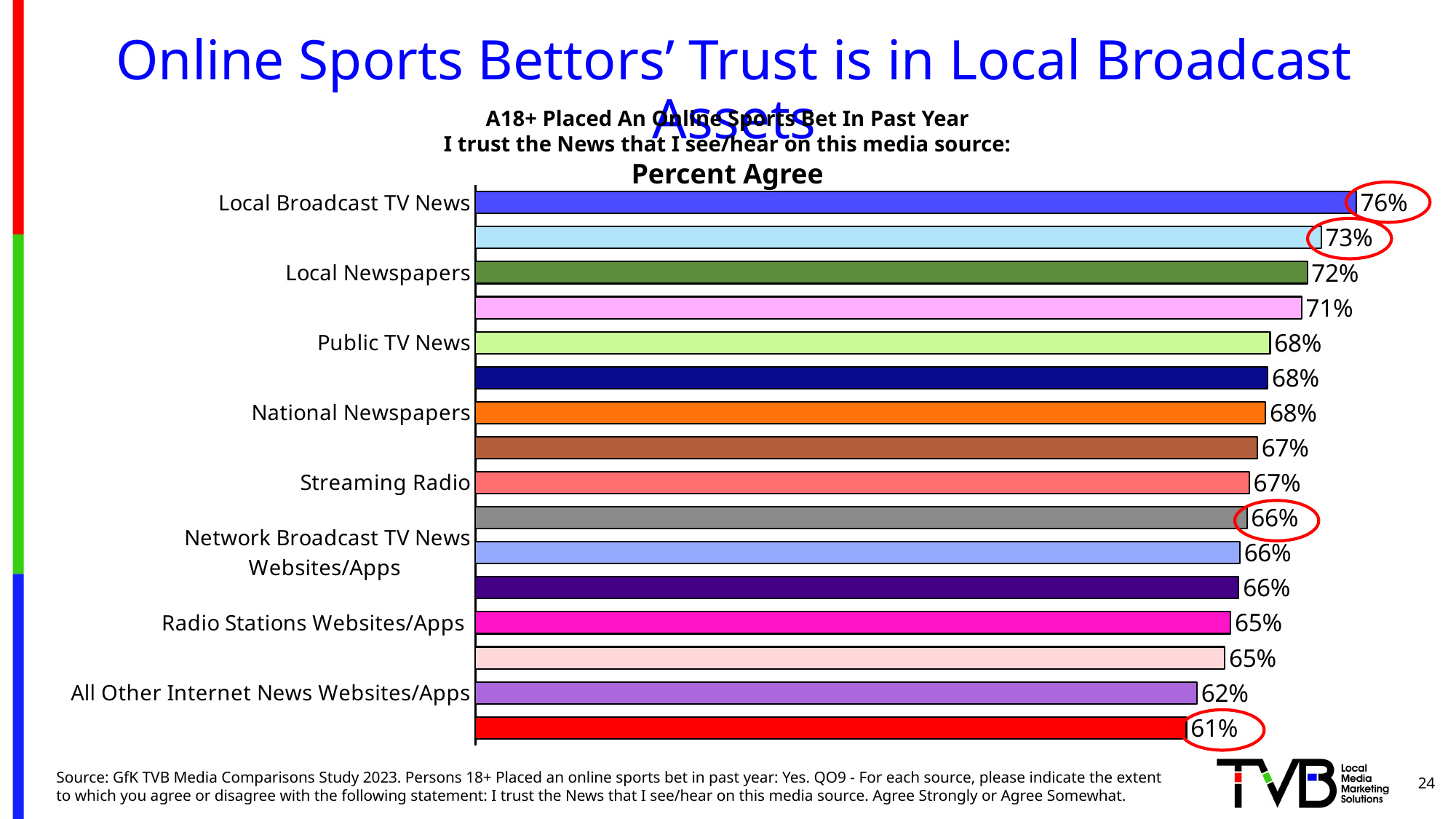
Which has a higher Percent Agree value, National Newspapers or Streaming Radio? National Newspapers What type of chart is shown on the slide? Bar chart Which labeled media source has the highest Percent Agree value? Local Broadcast TV News What is the Percent Agree value for Streaming Radio? 67% What is the Percent Agree value for All Other Internet News Websites/Apps? 62% How many bars are plotted on the chart? 16 What is the Percent Agree value for Radio Stations Websites/Apps? 65% What is the Percent Agree value for Local Newspapers? 72% What percentage of online sports bettors agree they trust the news on Local Broadcast TV News? 76% What is the lowest Percent Agree value shown on the chart? 61% How many percentage points higher is Local Broadcast TV News than Local Newspapers? 4 What is the Percent Agree value for Public TV News? 68%